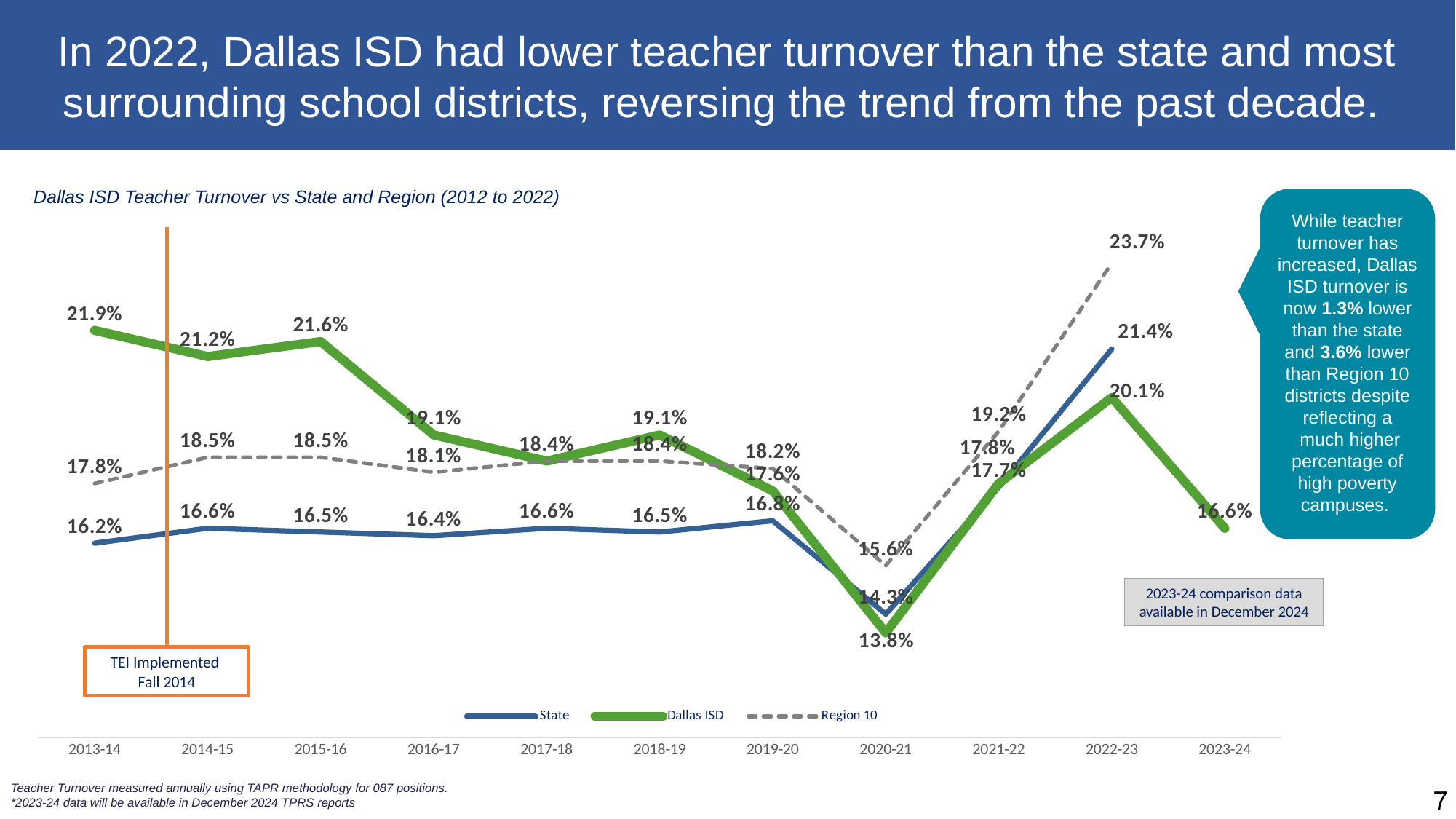
In which school year was the Dallas ISD turnover rate lowest? 2020-21 In 2013-14, which had the higher turnover rate, Dallas ISD or the State? Dallas ISD How many series does the chart's legend list? 3 In 2022-23, how much higher was the State turnover rate than the Dallas ISD rate? 1.3 percentage points What was the Dallas ISD teacher turnover rate in 2013-14? 21.9% How many school years are shown on the x axis of the chart? 11 What type of chart is used to show teacher turnover on this slide? Line chart In which school year was the Region 10 turnover rate highest? 2022-23 What was the Dallas ISD teacher turnover rate in 2023-24? 16.6% In 2022-23, how much higher was the Region 10 turnover rate than the Dallas ISD rate? 3.6 percentage points What was the State teacher turnover rate in 2022-23? 21.4% What was the Region 10 teacher turnover rate in 2022-23? 23.7%